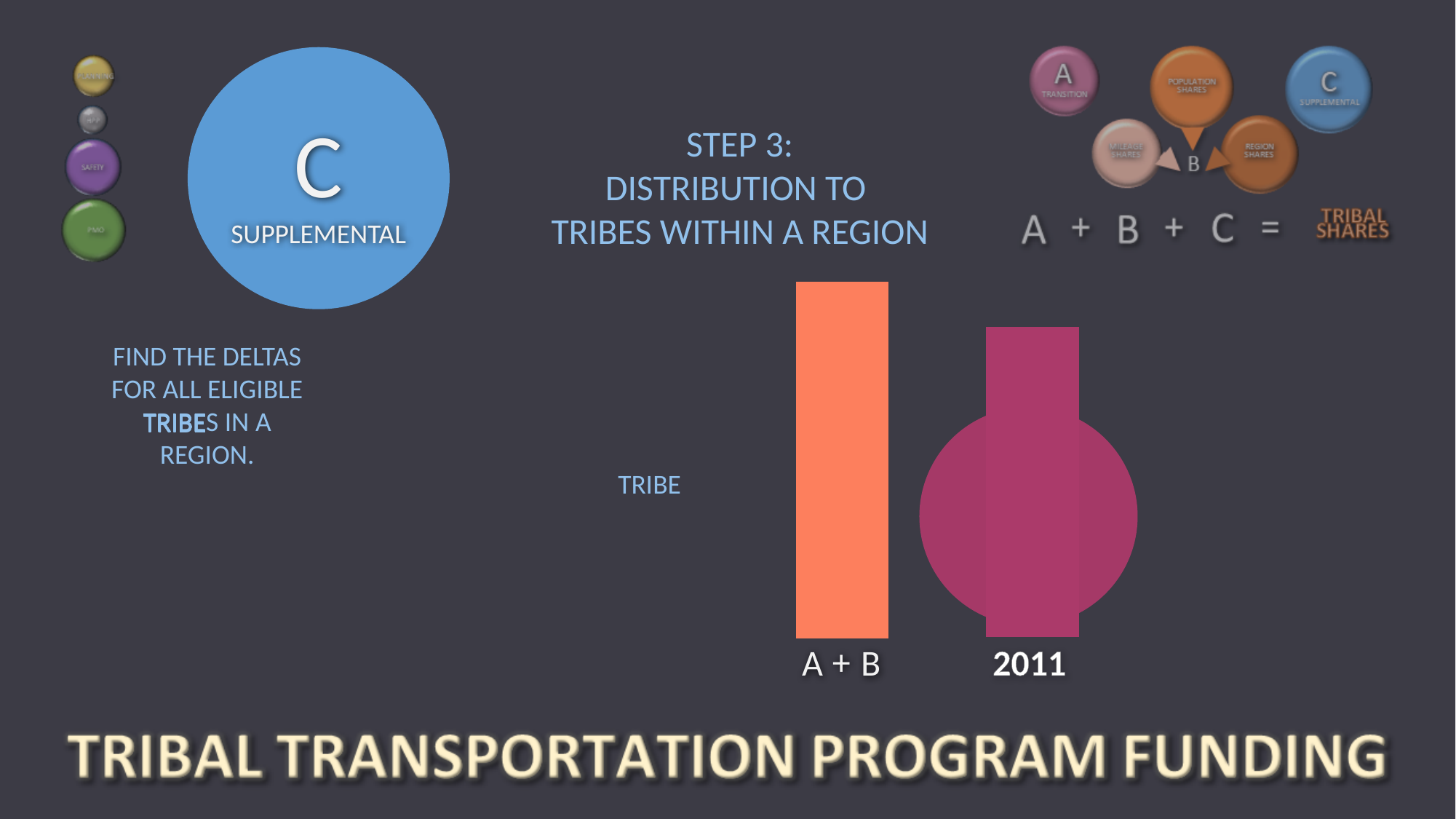
How many bars are shown in the chart in the centre of the slide? 2 Which bar is taller in the centre chart, "A + B" or "2011"? A + B What label appears to the left of the bars in the centre chart? TRIBE What colour is the "A + B" bar in the centre chart? orange What kind of chart is shown in the centre of the slide, with bars labelled "A + B" and "2011"? bar chart Which category has the highest bar in the centre chart? A + B Which category has the lowest bar in the centre chart? 2011